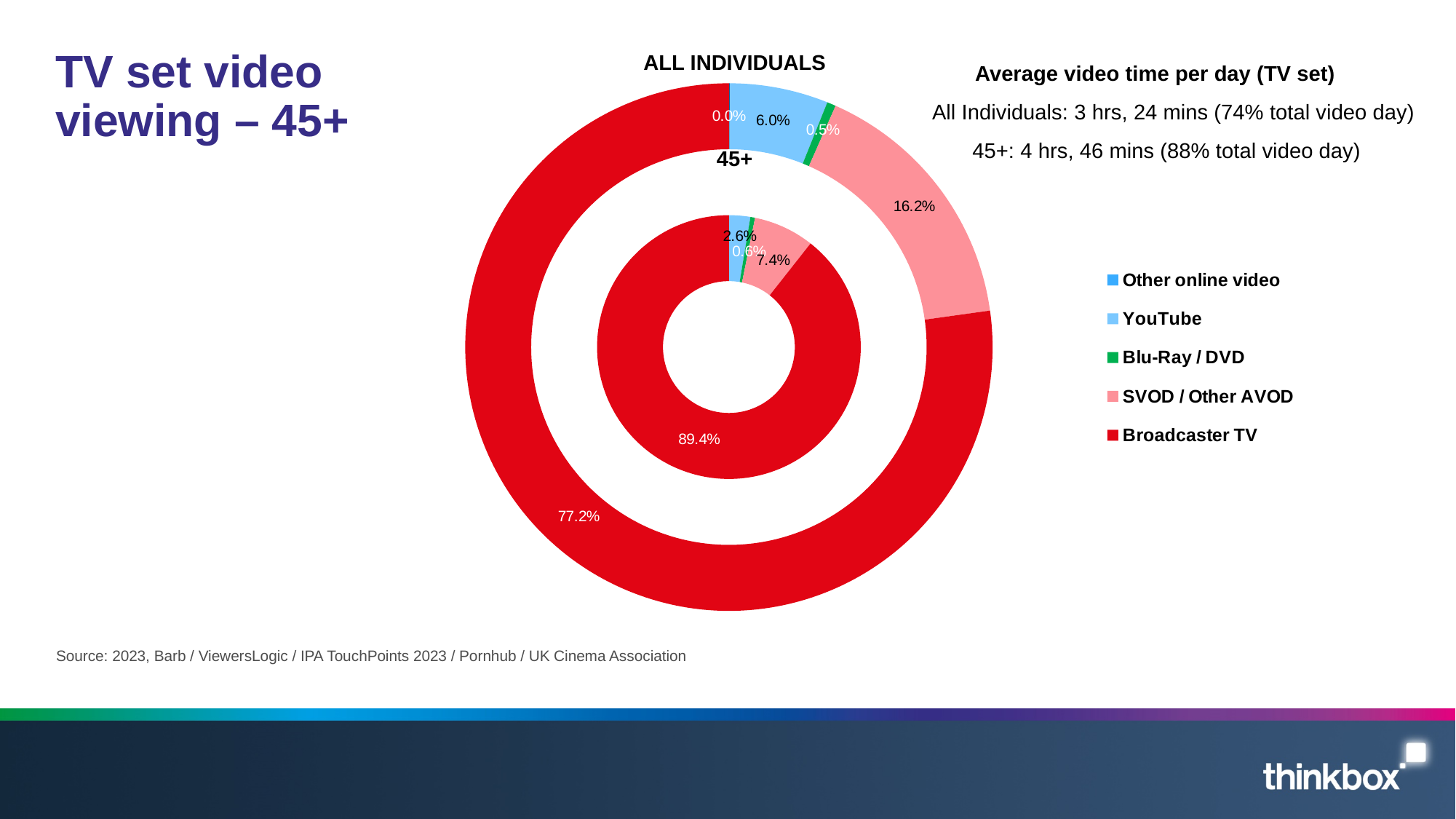
What is the SVOD / Other AVOD share for the 45+ group? 7.4% What kind of chart is shown on the slide? Doughnut chart What is the YouTube share for All Individuals? 6.0% What share of TV set video viewing for All Individuals is Broadcaster TV? 77.2% Which category has the smallest share in the All Individuals ring? Other online video Which category has the largest share in the 45+ ring? Broadcaster TV What share of TV set video viewing for the 45+ group is Broadcaster TV? 89.4% How much larger is the Broadcaster TV share for 45+ than for All Individuals? 12.2 percentage points How many categories does the legend list? 5 Which is larger: the SVOD / Other AVOD share for All Individuals or for 45+? All Individuals What is the Blu-Ray / DVD share for All Individuals? 0.5% Which colour represents Broadcaster TV in the chart? Red